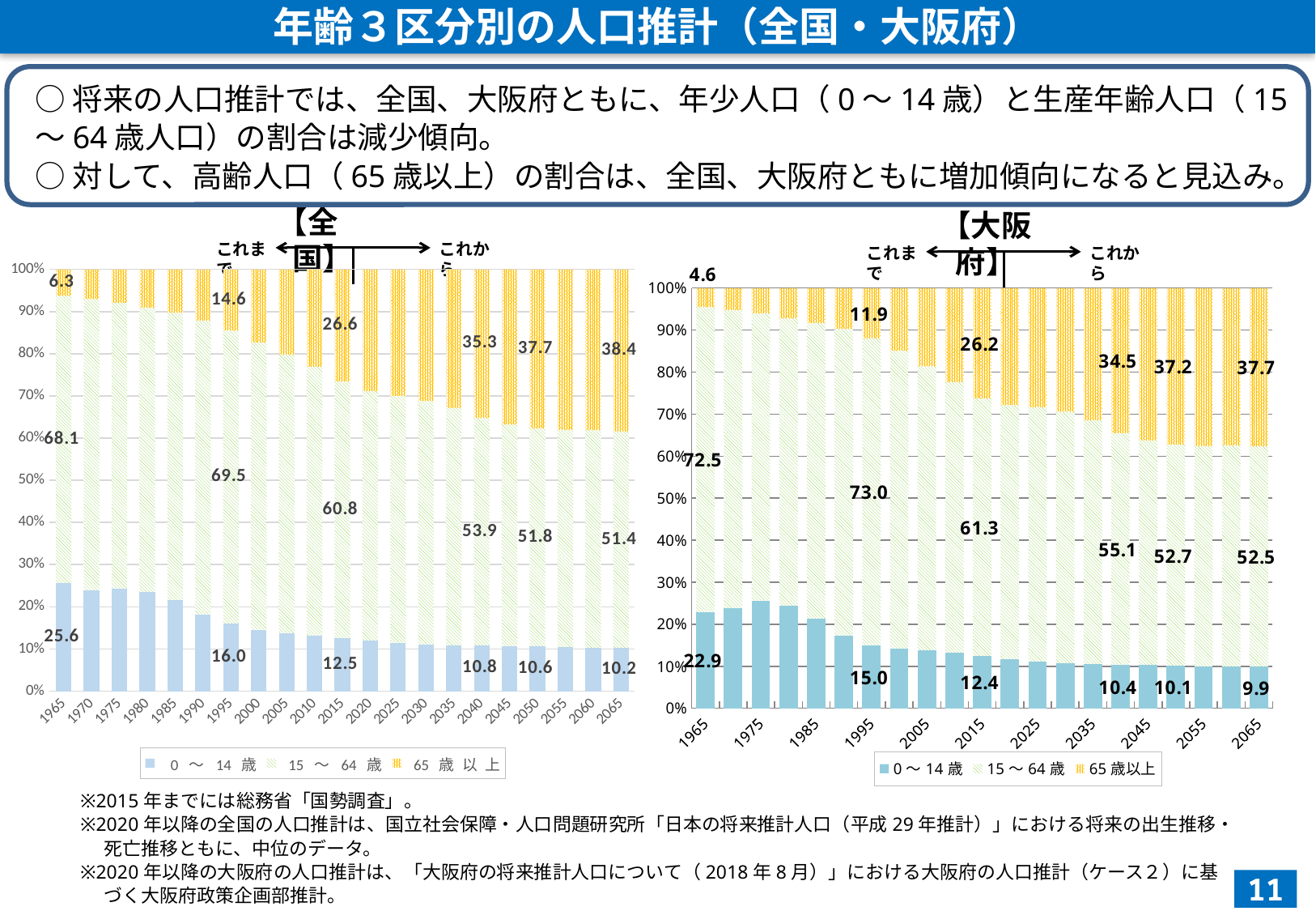
In the 【全国】 chart, does the 0～14歳 share rise or fall from 1965 to 2065? fall In the 【全国】 chart, what is the labelled value for 65歳以上 in 2065? 38.4 For 2065, which chart shows the larger 65歳以上 value, 【全国】 or 【大阪府】? 【全国】 In the 【大阪府】 chart, does the 65歳以上 share rise or fall from 1965 to 2065? rise In the 【大阪府】 chart, what is the labelled value for 15～64歳 in 1995? 73.0 What kind of chart is the 【全国】 chart on the left? stacked bar chart In the 【大阪府】 chart, by how much does the 65歳以上 value in 2065 exceed the value in 1965? 33.1 In the 【全国】 chart, which series is shown in yellow according to the legend? 65歳以上 In the 【全国】 chart, what is the total of the three labelled values for 2065? 100.0 How many series does the legend of the 【大阪府】 chart list? 3 In the 【全国】 chart, what is the labelled value for 15～64歳 in 2015? 60.8 In the 【大阪府】 chart, what is the labelled value for 0～14歳 in 1965? 22.9